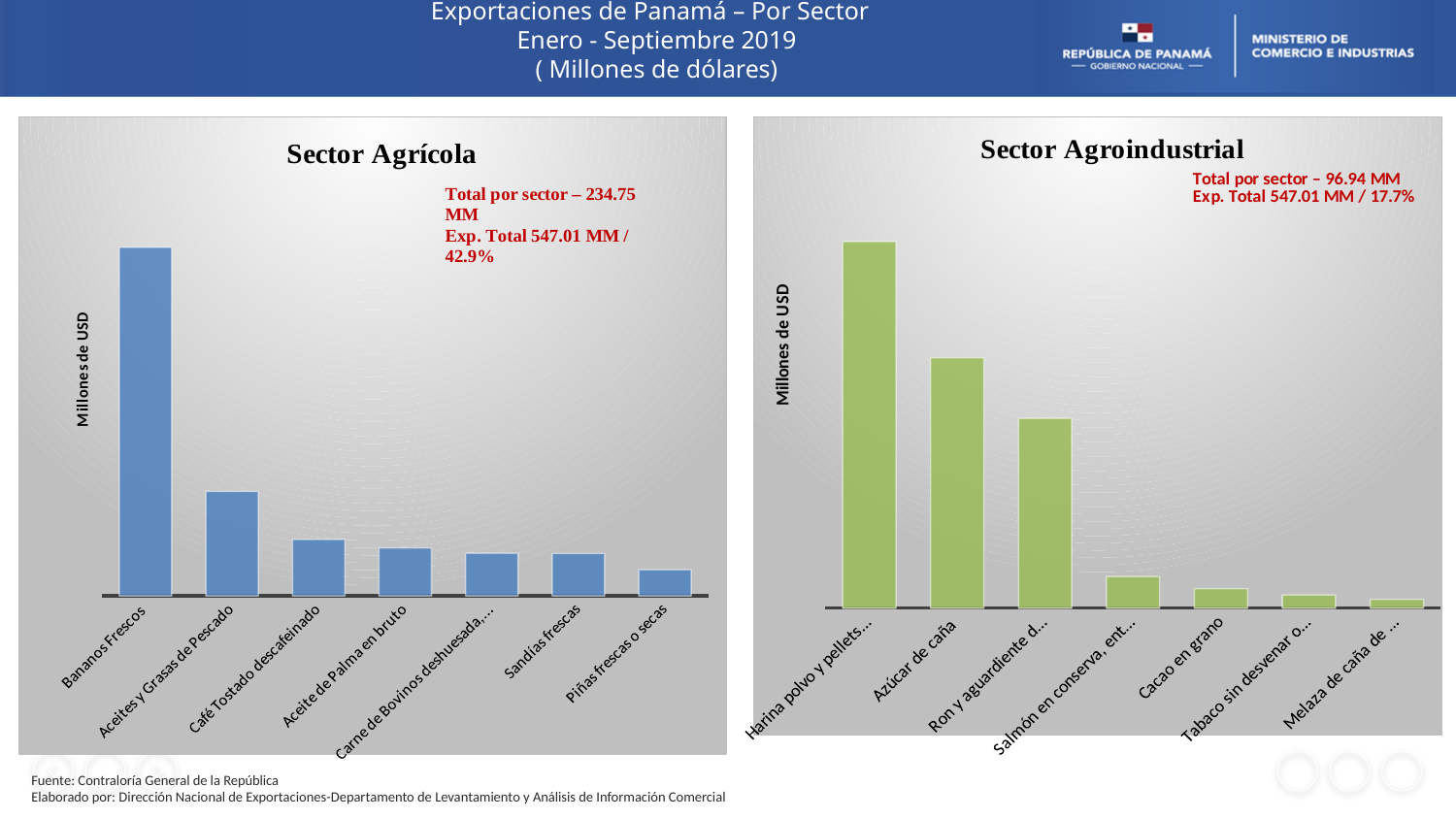
In the Sector Agrícola chart, which is larger: Bananos Frescos or Aceites y Grasas de Pescado? Bananos Frescos In the Sector Agroindustrial chart, which is larger: Azúcar de caña or Ron y aguardiente? Azúcar de caña According to the annotation on the Sector Agroindustrial chart, what percentage of total exports does the sector represent? 17.7% According to the annotation on the Sector Agrícola chart, what is the total for the sector? 234.75 MM In the Sector Agroindustrial chart, which category has the lowest value? Melaza de caña How many categories are shown in the Sector Agroindustrial chart? 7 In the Sector Agrícola chart, which category has the lowest value? Piñas frescas o secas How many categories are shown in the Sector Agrícola chart? 7 In the Sector Agroindustrial chart, which category has the highest value? Harina polvo y pellets In the Sector Agrícola chart, do the values rise or fall from left to right along the x axis? Fall In the Sector Agrícola chart, which category has the highest value? Bananos Frescos What kind of chart is the Sector Agrícola chart? Bar chart